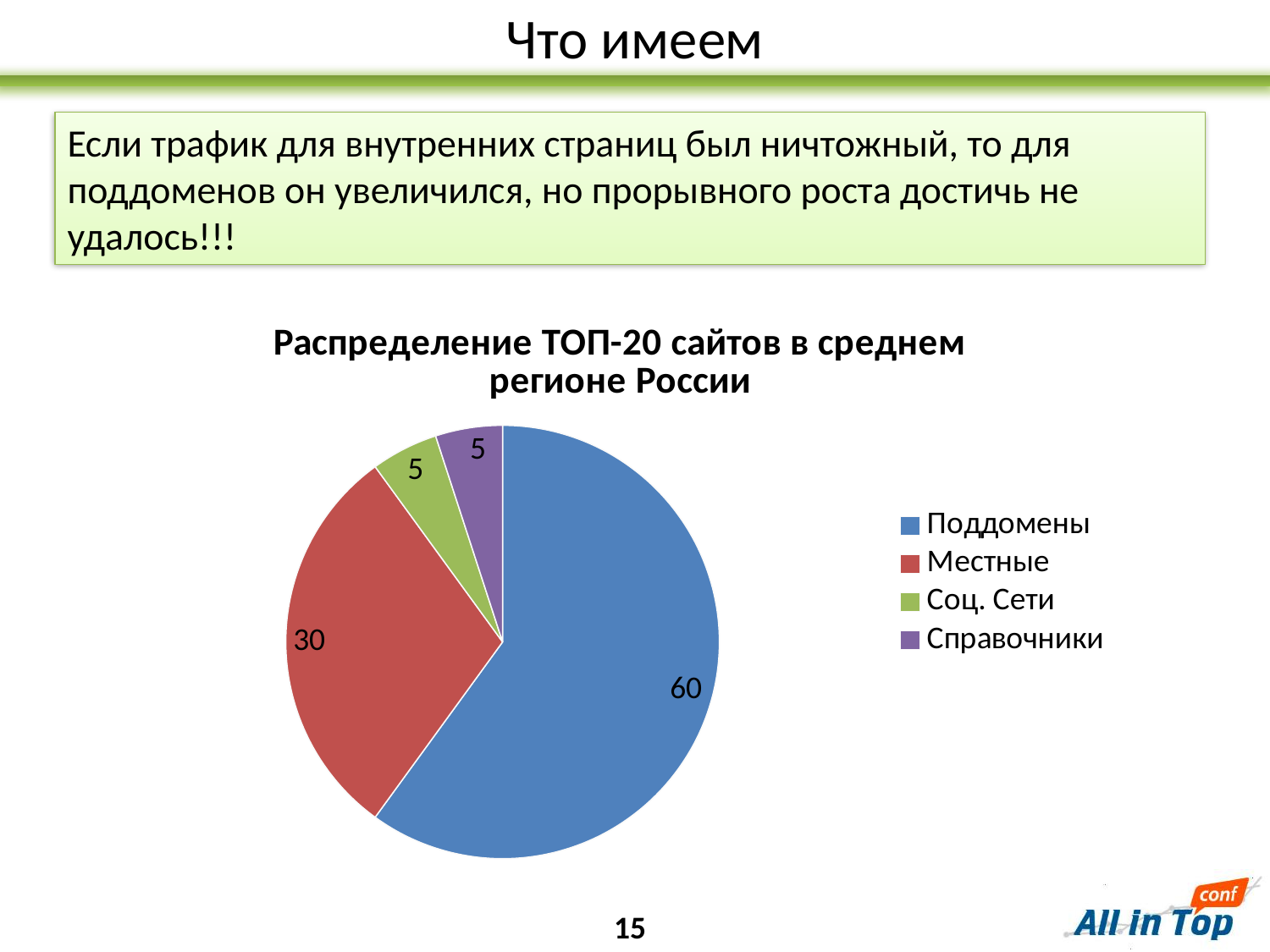
What is the difference between the values for Поддомены and Местные? 30 What kind of chart is shown on the slide? Pie chart What is the title of the chart? Распределение ТОП-20 сайтов в среднем регионе России What is the value for Справочники in the pie chart? 5 What is the value for Местные in the pie chart? 30 What share of the pie does Поддомены represent? 60% What colour is the slice for Местные? Red What is the value for Поддомены in the pie chart? 60 Which is larger, the value for Местные or the value for Справочники? Местные What is the value for Соц. Сети in the pie chart? 5 How many categories does the pie chart show? 4 Which category has the largest slice of the pie chart? Поддомены